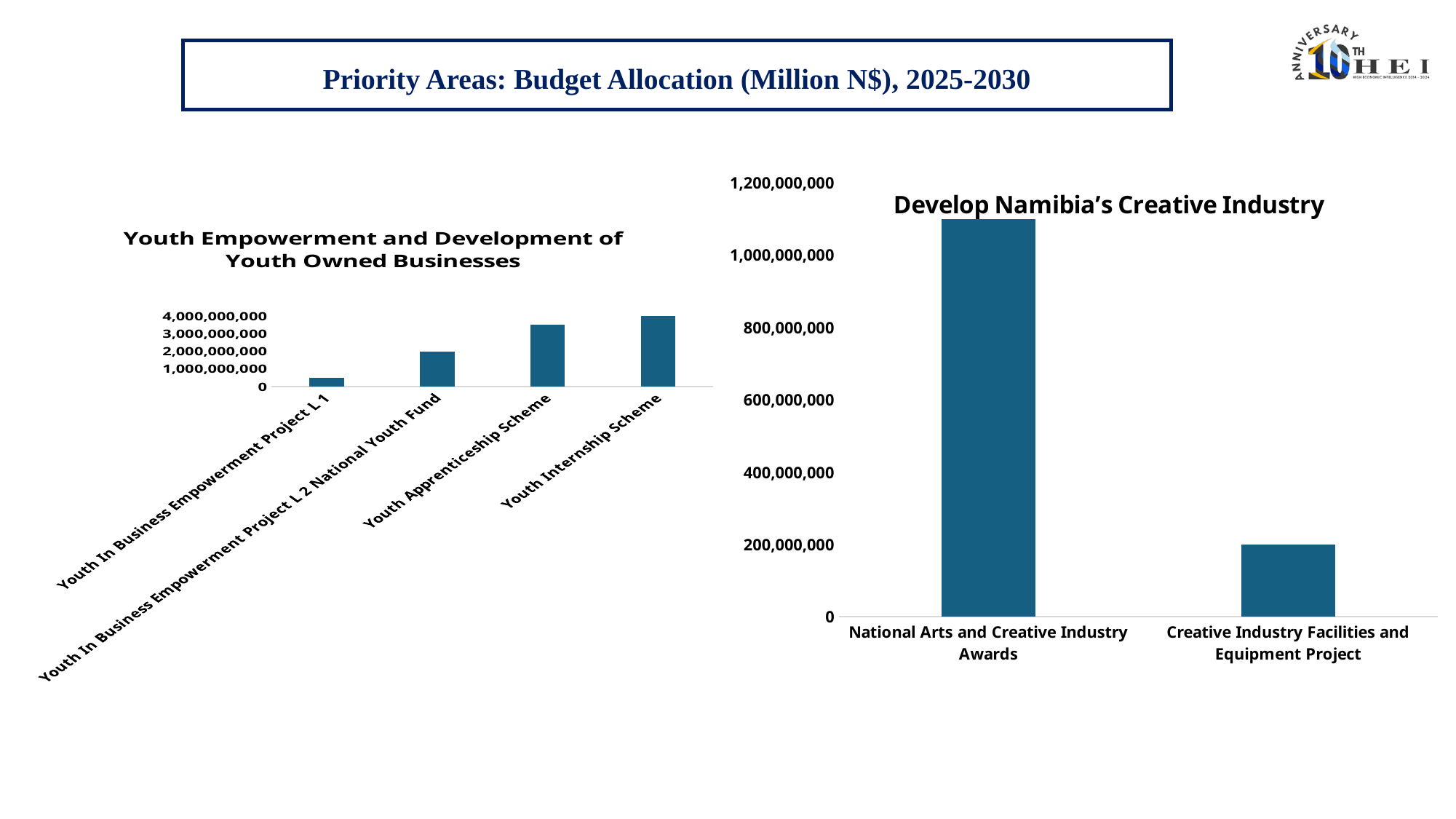
In the 'Develop Namibia's Creative Industry' chart, is the value for National Arts and Creative Industry Awards greater or less than 1,000,000,000? greater What kind of chart is the 'Develop Namibia's Creative Industry' chart? bar chart How many categories are shown in the 'Develop Namibia's Creative Industry' chart? 2 In the 'Youth Empowerment and Development of Youth Owned Businesses' chart, which category has the highest value? Youth Internship Scheme In the 'Develop Namibia's Creative Industry' chart, is the value for Creative Industry Facilities and Equipment Project greater or less than 400,000,000? less In the 'Youth Empowerment and Development of Youth Owned Businesses' chart, is the value for Youth In Business Empowerment Project L 1 greater or less than 1,000,000,000? less In the 'Develop Namibia's Creative Industry' chart, which category has the highest value? National Arts and Creative Industry Awards How many categories are shown in the 'Youth Empowerment and Development of Youth Owned Businesses' chart? 4 What is the title of the chart on the left side of the slide? Youth Empowerment and Development of Youth Owned Businesses In the 'Youth Empowerment and Development of Youth Owned Businesses' chart, do the values rise or fall from left to right along the x axis? rise In the 'Youth Empowerment and Development of Youth Owned Businesses' chart, which category has the lowest value? Youth In Business Empowerment Project L 1